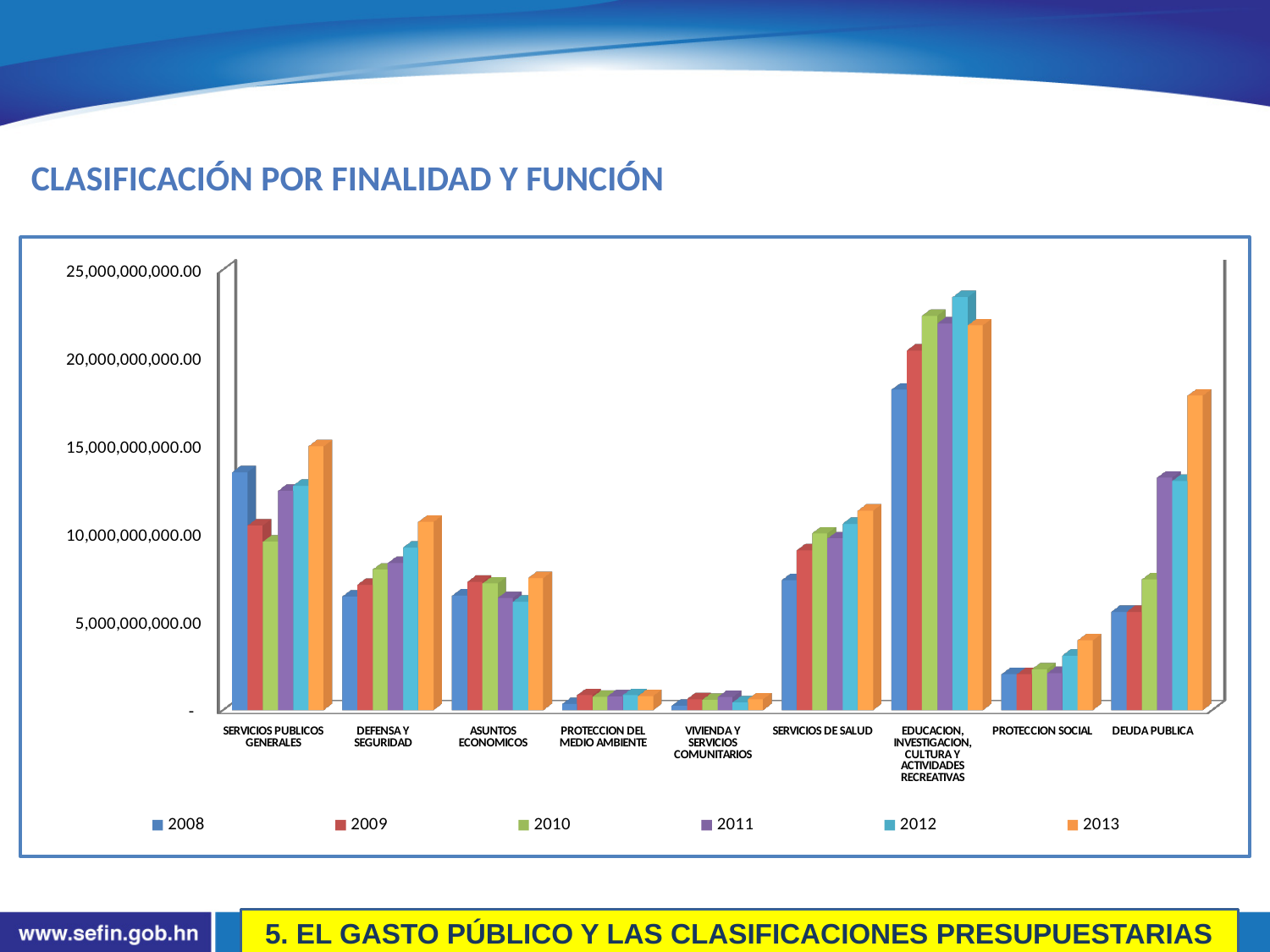
For EDUCACION, INVESTIGACION, CULTURA Y ACTIVIDADES RECREATIVAS, which year has the larger value, 2008 or 2012? 2012 Which category has the highest bars in the chart? EDUCACION, INVESTIGACION, CULTURA Y ACTIVIDADES RECREATIVAS How many categories are shown along the x axis of the chart? 9 Is the 2013 value for PROTECCION SOCIAL greater or less than 5,000,000,000.00? less Is the 2013 value for DEUDA PUBLICA greater or less than 15,000,000,000.00? greater Which colour represents the 2013 series in the legend? Orange Is the 2008 value for SERVICIOS DE SALUD greater or less than 10,000,000,000.00? less What is the title of the chart on the slide? CLASIFICACIÓN POR FINALIDAD Y FUNCIÓN How many series does the legend list? 6 For DEUDA PUBLICA, which year has the larger value, 2008 or 2013? 2013 What kind of chart is shown on the slide? Bar chart